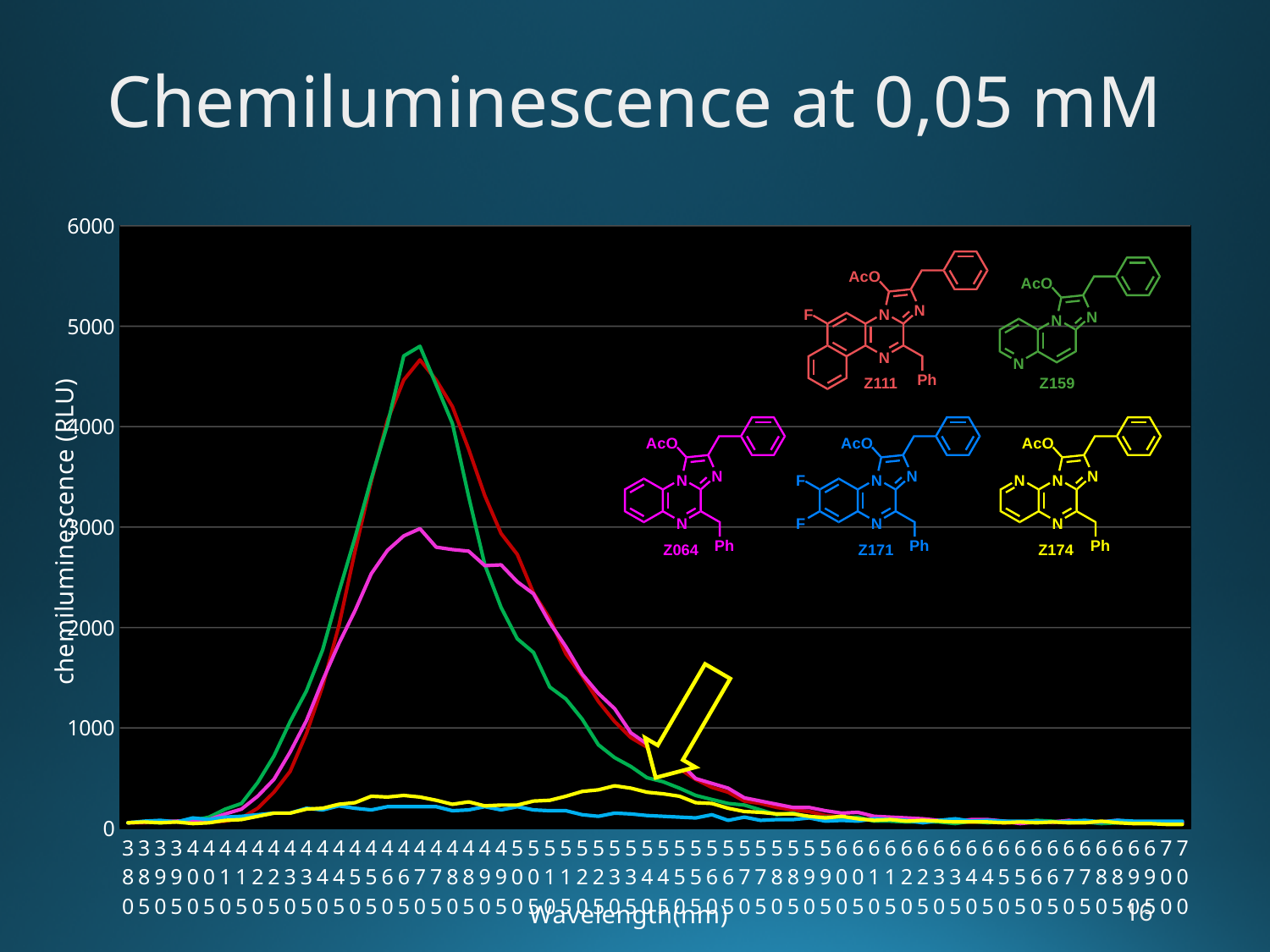
Which compound is plotted with the red line? Z111 Is the peak value of the blue line (Z171) greater or less than 1000? less Do the values of the red line rise or fall between 500 nm and 700 nm? fall What is the title of the chart? Chemiluminescence at 0,05 mM What kind of chart is shown on the slide? line chart Which compound's line has the lowest peak on the chart? Z171 (blue) Which line reaches a higher peak, the red line (Z111) or the yellow line (Z174)? red (Z111) How many compound series are plotted on the chart? 5 Which line reaches a higher peak, the green line (Z159) or the magenta line (Z064)? green (Z159) Is the peak value of the green line (Z159) greater or less than 4000? greater Is the peak value of the magenta line (Z064) greater or less than 2000? greater